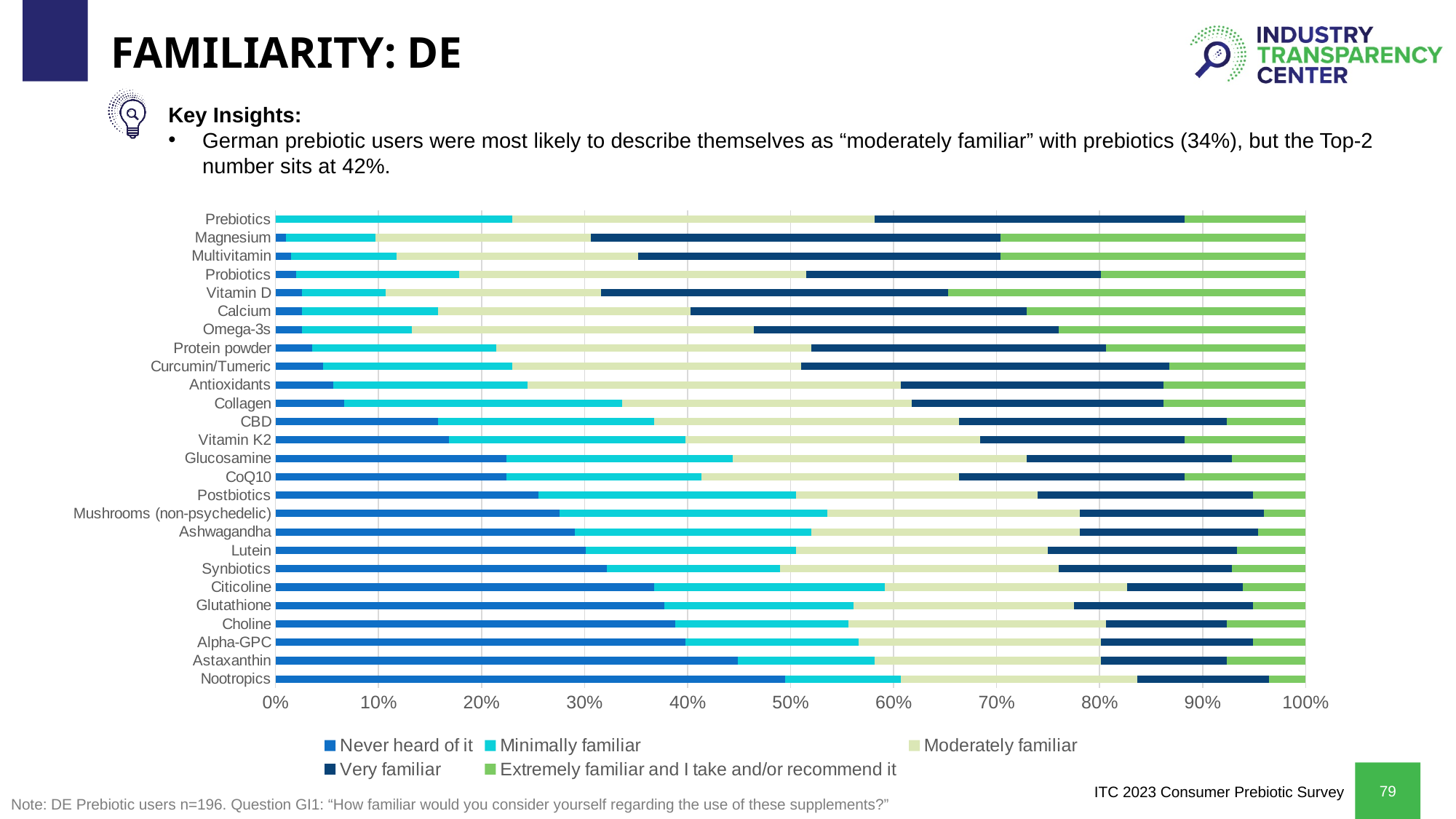
Which supplement has the largest 'Never heard of it' share? Nootropics What kind of chart is shown on the slide? Stacked bar chart Which has a larger 'Never heard of it' share, Astaxanthin or Citicoline? Astaxanthin What is the maximum value shown on the horizontal axis? 100% Moving from the top of the chart (Prebiotics) to the bottom (Nootropics), does the 'Never heard of it' share generally increase or decrease? Increase Is the 'Never heard of it' value for Magnesium greater or less than 10%? less How many series does the chart legend list? 5 Which has a larger 'Never heard of it' share, Prebiotics or Nootropics? Nootropics How many supplement categories are plotted on the chart? 26 Is the 'Never heard of it' value for Nootropics greater or less than 40%? greater Is the 'Never heard of it' value for Citicoline greater or less than 40%? less Which legend entry is shown in green? Extremely familiar and I take and/or recommend it